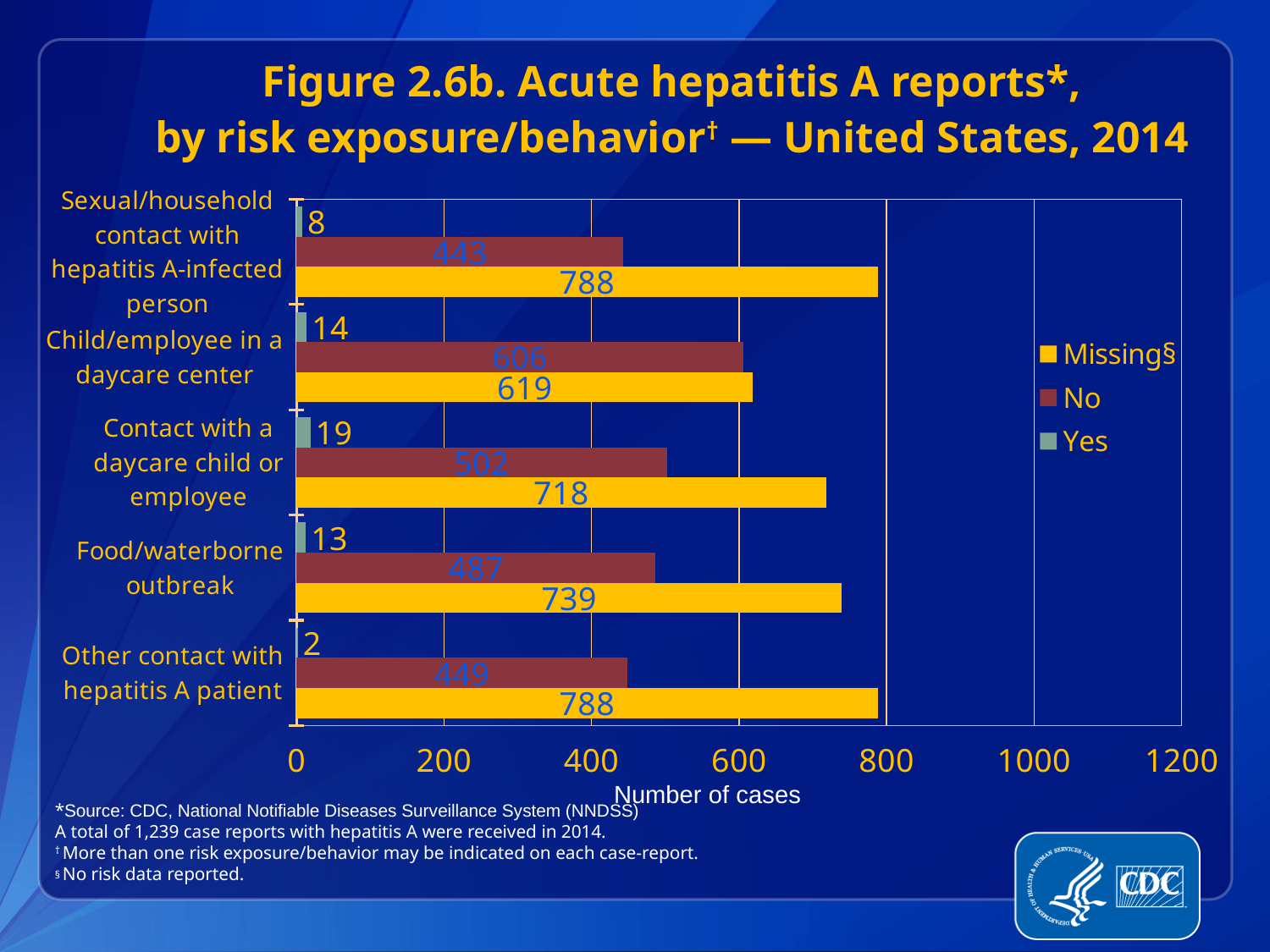
How many risk exposure/behavior categories are shown on the chart? 5 Which risk exposure/behavior has the lowest "Missing" value? Child/employee in a daycare center Is the "Missing" value for Contact with a daycare child or employee greater or less than 600? greater Which risk exposure/behavior has the lowest "Yes" value? Other contact with hepatitis A patient What is the difference between the "Missing" and "No" values for Food/waterborne outbreak? 252 How many cases are reported as "Yes" for Contact with a daycare child or employee? 19 What is the "No" value for Child/employee in a daycare center? 606 What is the "Missing" value for Food/waterborne outbreak? 739 Which risk exposure/behavior has the highest "Yes" value? Contact with a daycare child or employee Is the "No" value larger for Child/employee in a daycare center or for Sexual/household contact with hepatitis A-infected person? Child/employee in a daycare center How many series does the legend list? 3 What kind of chart is shown on the slide? bar chart